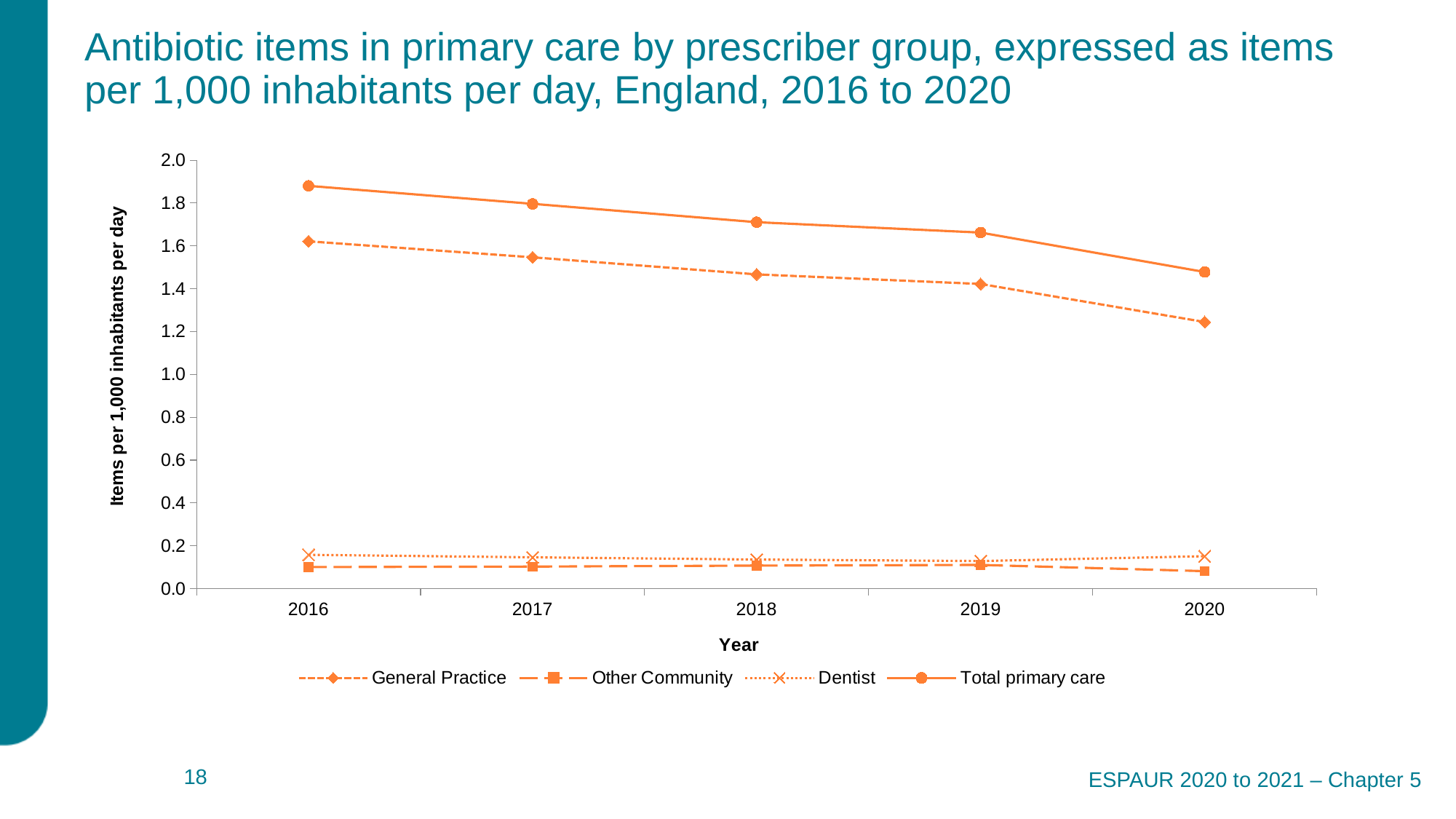
How many years are plotted along the x axis? 5 How many series does the legend list? 4 Is the value for General Practice in 2020 greater or less than 1.4? less Which series has the highest value in 2016? Total primary care What kind of chart is shown on the slide? line chart Is the value for Total primary care in 2016 greater or less than 1.8? greater Which is larger: the General Practice value in 2016 or in 2020? 2016 In which year is the General Practice value lowest? 2020 Which series has the lowest value in 2020? Other Community In which year is the Total primary care value highest? 2016 Is the value for Total primary care in 2020 greater or less than 1.6? less Does the Total primary care series rise or fall from 2016 to 2020? fall